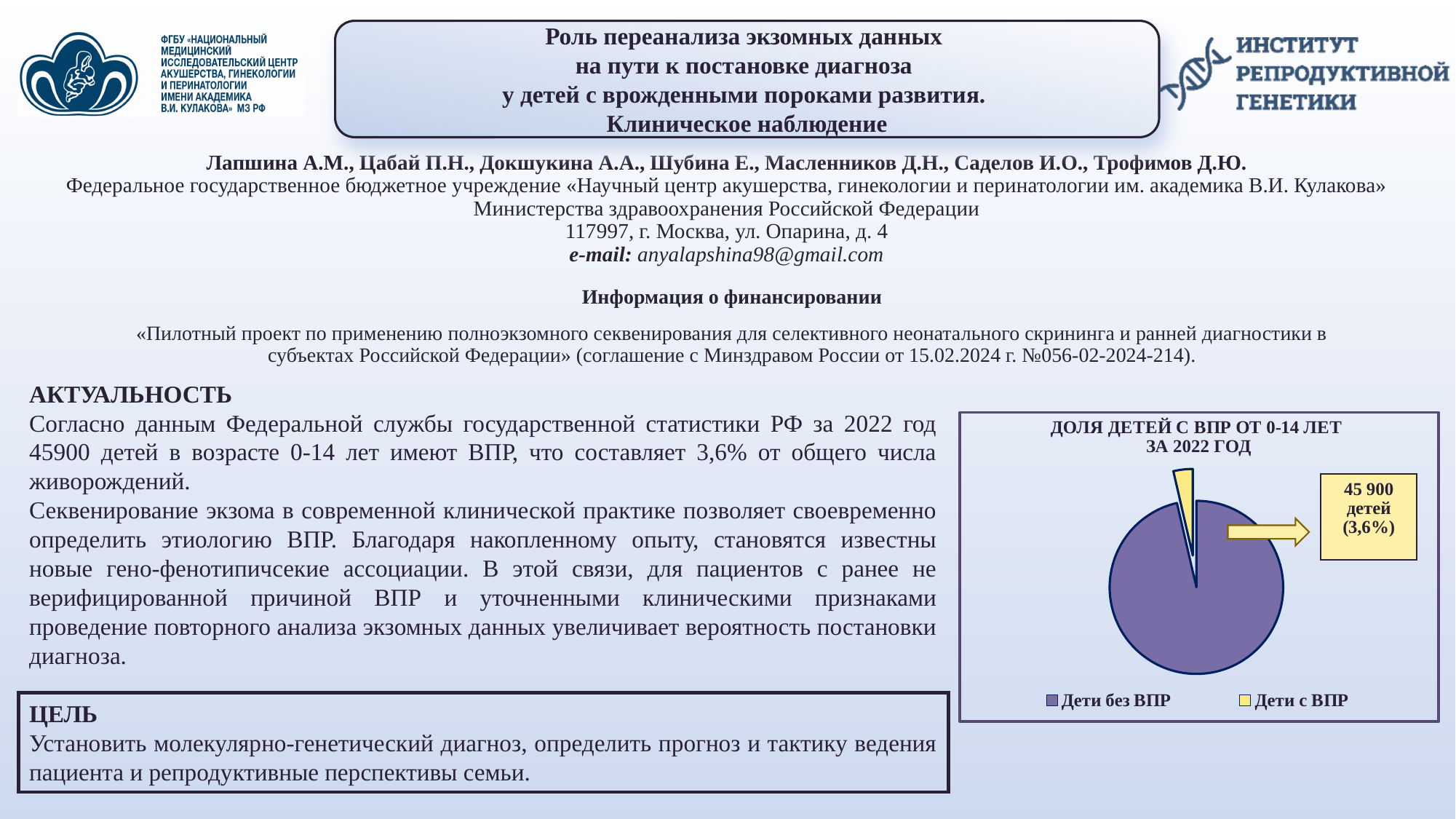
Which slice of the pie chart is the smallest? Дети с ВПР Which is larger in the pie chart: Дети без ВПР or Дети с ВПР? Дети без ВПР What share of the pie does the slice Дети с ВПР represent? 3,6% What is the title of the pie chart? ДОЛЯ ДЕТЕЙ С ВПР ОТ 0-14 ЛЕТ ЗА 2022 ГОД How many entries does the legend of the pie chart list? 2 What colour is the slice for Дети с ВПР in the pie chart? yellow How many children does the callout next to the Дети с ВПР slice give? 45 900 Which slice of the pie chart is the largest? Дети без ВПР What kind of chart is shown on the slide? pie chart How many slices does the pie chart have? 2